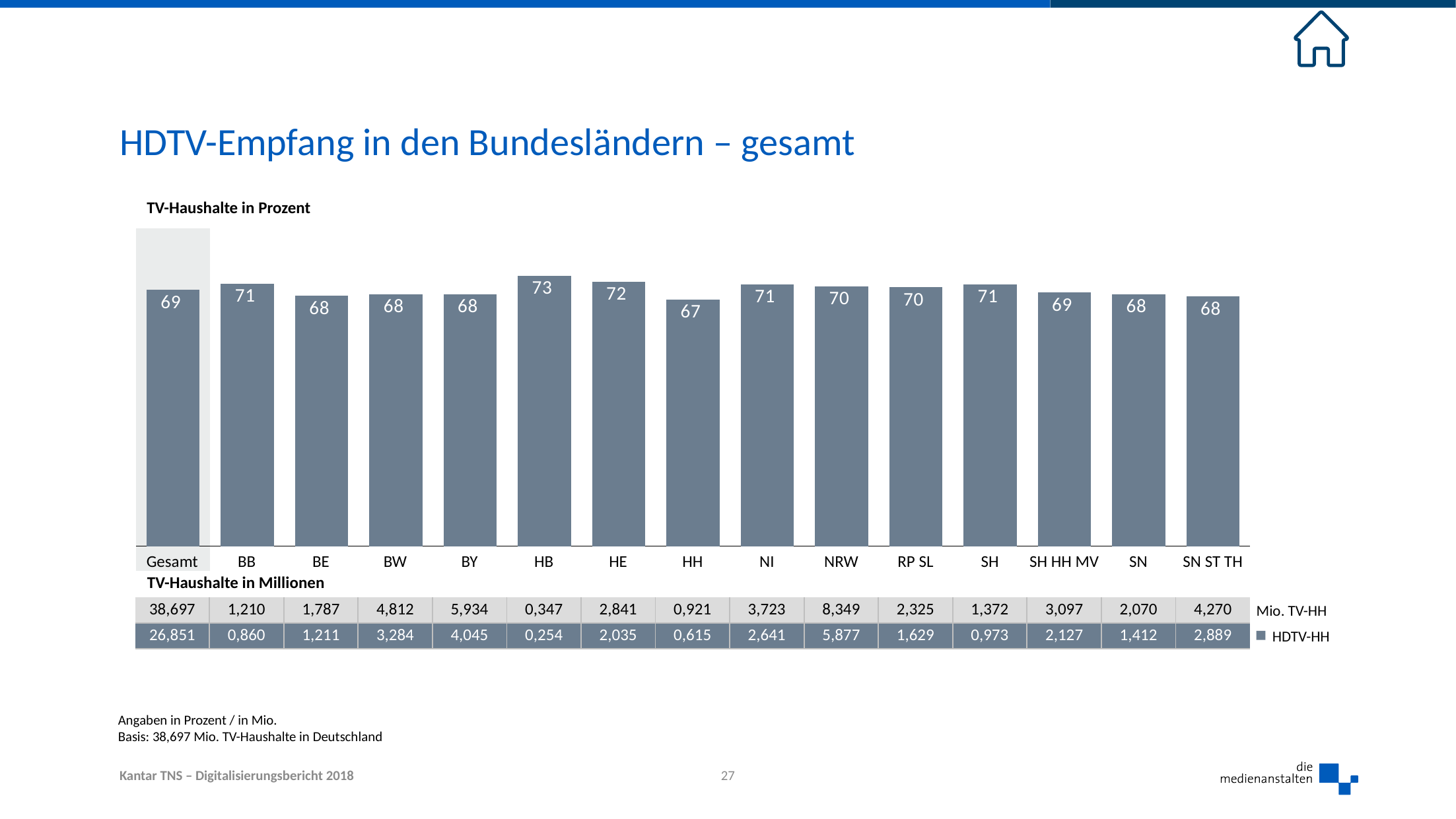
What kind of chart is shown on the slide? bar chart What is the value shown for Gesamt in the bar chart? 69 What is the HDTV reception percentage for HB? 73 How many categories are shown on the x axis of the bar chart? 15 Which category has the highest value in the bar chart? HB According to the table, how many Mio. TV-HH are listed for NRW? 8,349 What is the difference between the values for HB and HH? 6 Which has a higher value, HE or NRW? HE What is the value shown for NI in the bar chart? 71 What is the title of the slide? HDTV-Empfang in den Bundesländern – gesamt According to the table, what is the HDTV-HH value for BY? 4,045 Which category has the lowest value in the bar chart? HH